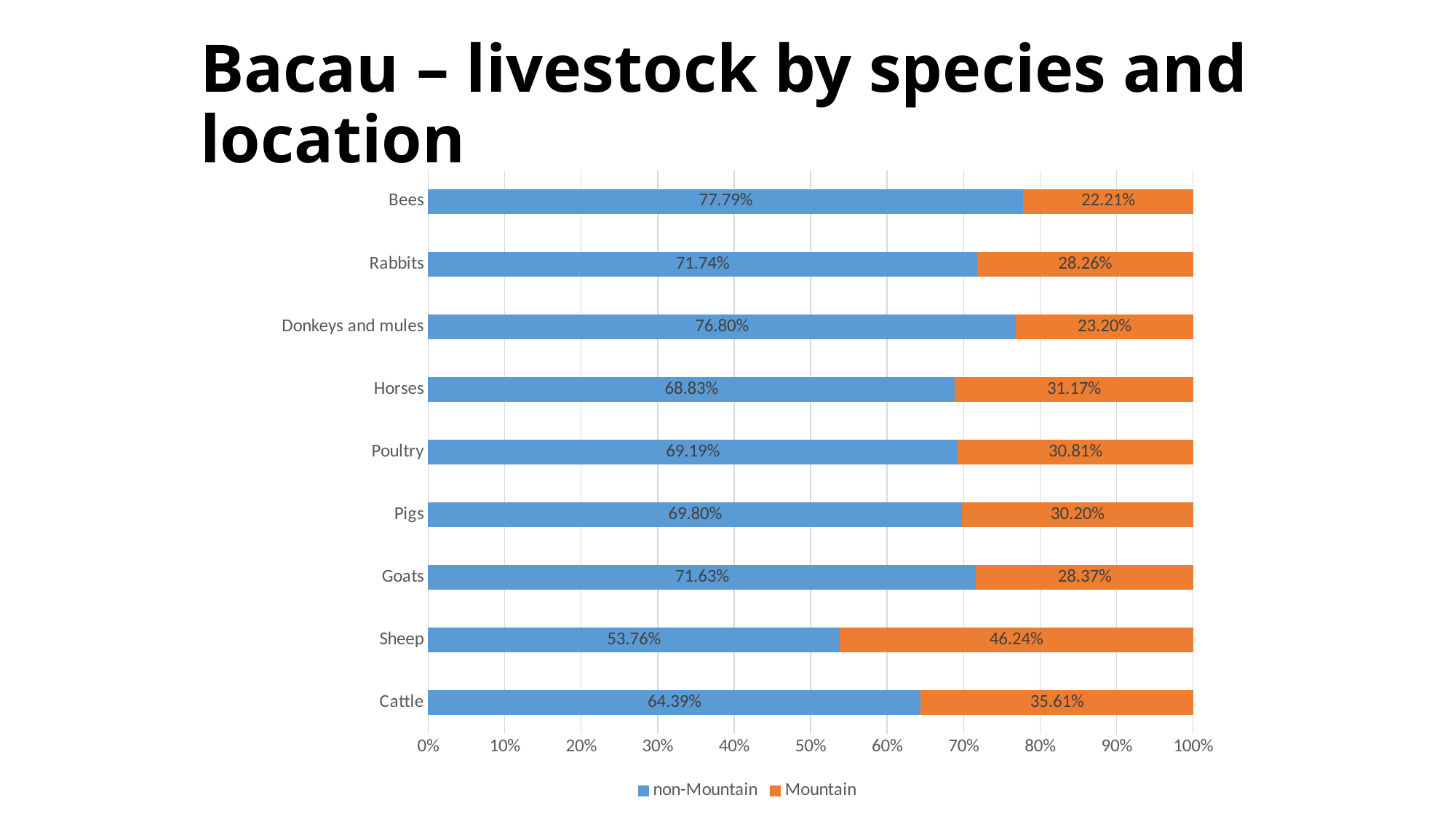
What is the Mountain share for Donkeys and mules? 23.20% What kind of chart is shown on the slide? Stacked bar chart What is the Mountain share for Sheep? 46.24% What is the difference between the non-Mountain and Mountain shares for Cattle? 28.78% What is the non-Mountain share for Bees? 77.79% Which species has the lowest Mountain share? Bees What colour represents the Mountain series? Orange Which is larger, the Mountain share for Horses or the Mountain share for Goats? Horses How many species are shown on the chart? 9 Which species has the highest Mountain share? Sheep How many series does the legend list? 2 Which species has the lowest non-Mountain share? Sheep